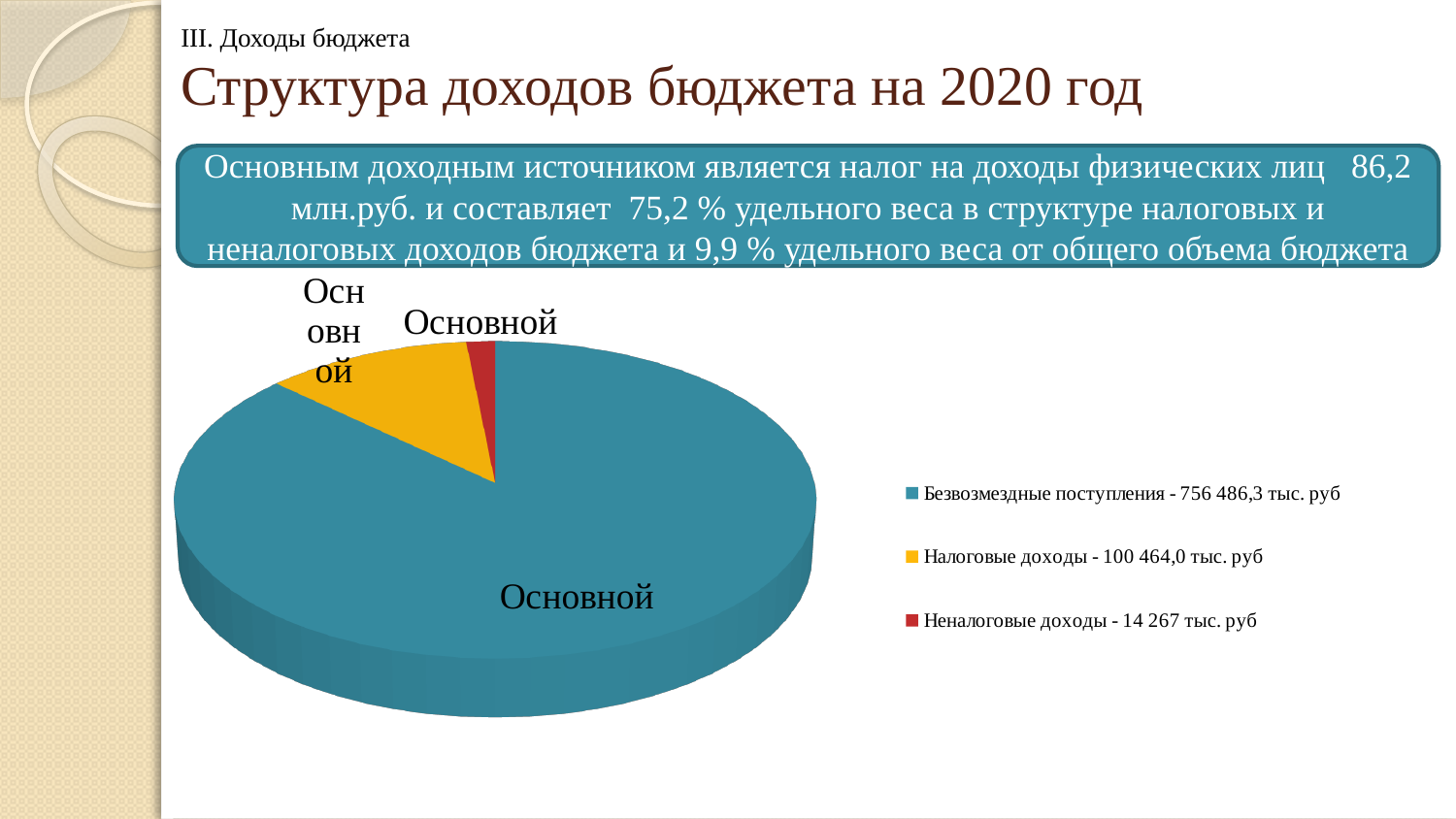
Which category has the smallest slice of the pie? Неналоговые доходы What colour is the slice for Безвозмездные поступления? Blue (teal) How many entries does the legend of the pie chart list? 3 What is the difference between Налоговые доходы and Неналоговые доходы, in тыс. руб? 86 197,0 тыс. руб What value does the legend give for Безвозмездные поступления? 756 486,3 тыс. руб Which category has the largest slice of the pie? Безвозмездные поступления What kind of chart is shown on the slide? Pie chart What value does the legend give for Налоговые доходы? 100 464,0 тыс. руб Which is larger, Налоговые доходы or Неналоговые доходы? Налоговые доходы What is the total of the three categories shown in the legend, in тыс. руб? 871 217,3 тыс. руб What value does the legend give for Неналоговые доходы? 14 267 тыс. руб How many slices does the pie chart have? 3